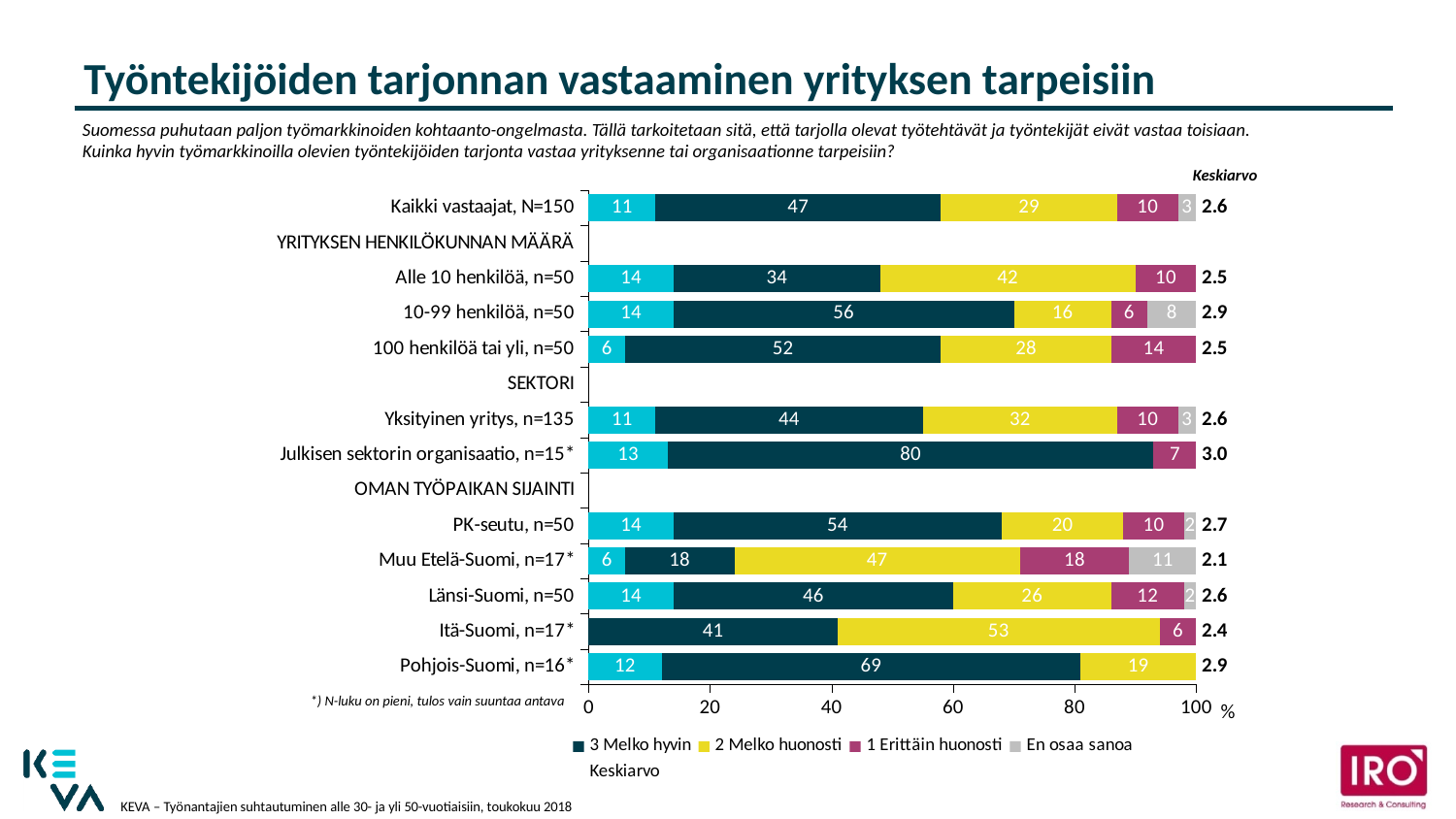
Which category has the lowest Keskiarvo value? Muu Etelä-Suomi, n=17* Which category has the highest Keskiarvo value? Julkisen sektorin organisaatio, n=15* What is the title of the slide? Työntekijöiden tarjonnan vastaaminen yrityksen tarpeisiin What is the difference between the '2 Melko huonosti' values for 'Alle 10 henkilöä, n=50' and '10-99 henkilöä, n=50'? 26 Which category has the highest '2 Melko huonosti' value? Itä-Suomi, n=17* What is the Keskiarvo value for 'Pohjois-Suomi, n=16*'? 2.9 What is the '1 Erittäin huonosti' value for '100 henkilöä tai yli, n=50'? 14 Which has the larger '3 Melko hyvin' value, 'PK-seutu, n=50' or 'Länsi-Suomi, n=50'? PK-seutu, n=50 How many bars (categories) are plotted in the chart? 11 What is the '3 Melko hyvin' value for 'Julkisen sektorin organisaatio, n=15*'? 80 What is the 'En osaa sanoa' value for '10-99 henkilöä, n=50'? 8 What kind of chart is shown on the slide? stacked bar chart